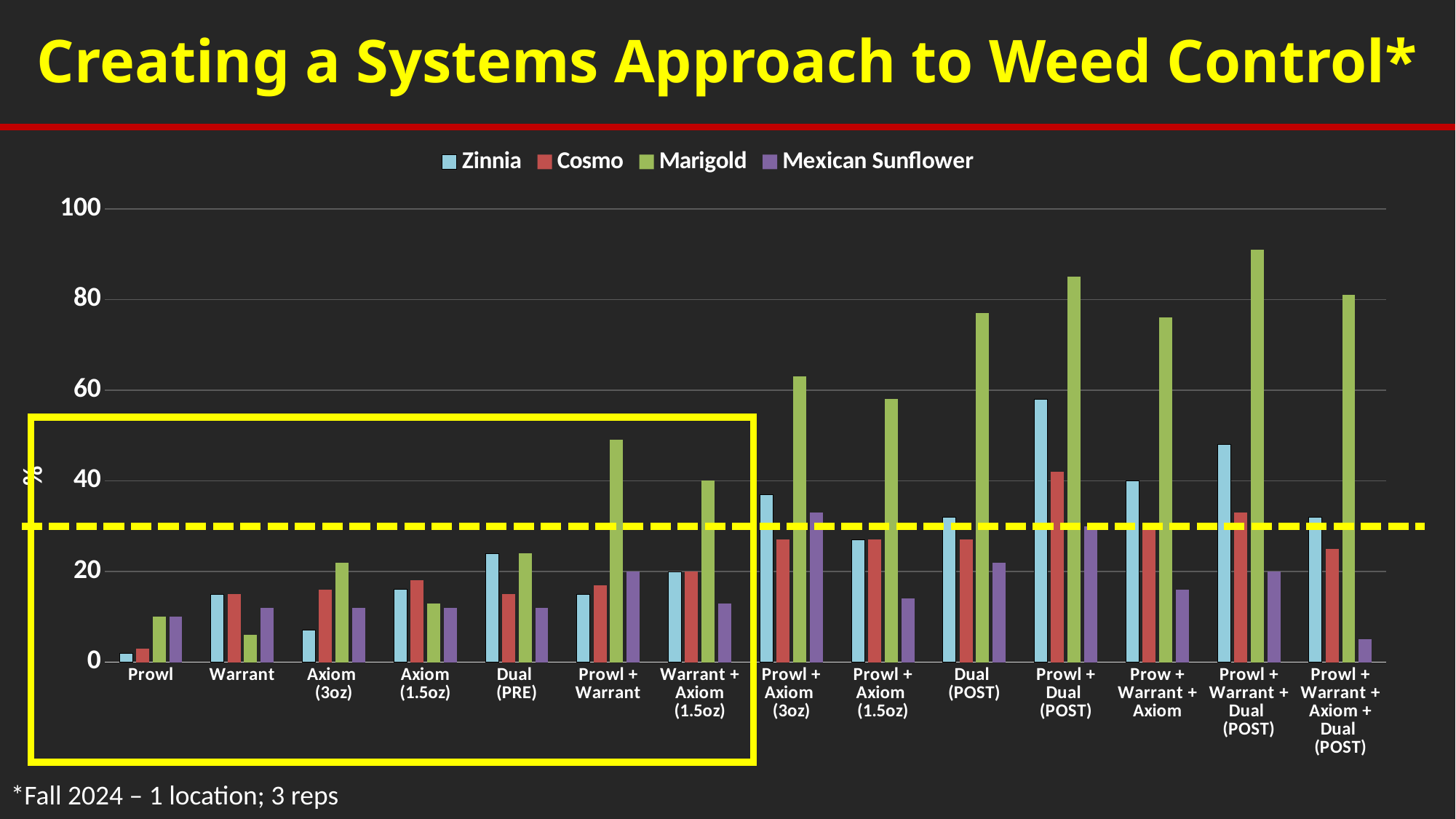
Which colour represents Marigold in the legend? green For which treatment is the Zinnia bar the highest? Prowl + Dual (POST) Is the Mexican Sunflower value for Prowl + Warrant + Axiom + Dual (POST) greater or less than 20? less Which series has the tallest bar anywhere on the chart? Marigold How many treatment categories are shown along the x axis? 14 For Dual (POST), which is larger: the Marigold value or the Zinnia value? Marigold For which treatment is the Marigold bar the highest? Prowl + Warrant + Dual (POST) What kind of chart is shown on the slide? bar chart How many series does the legend list? 4 For which treatment is the Zinnia bar the lowest? Prowl Is the Marigold value for Prowl + Dual (POST) greater or less than 80? greater Is the Marigold value for Dual (POST) greater or less than 60? greater